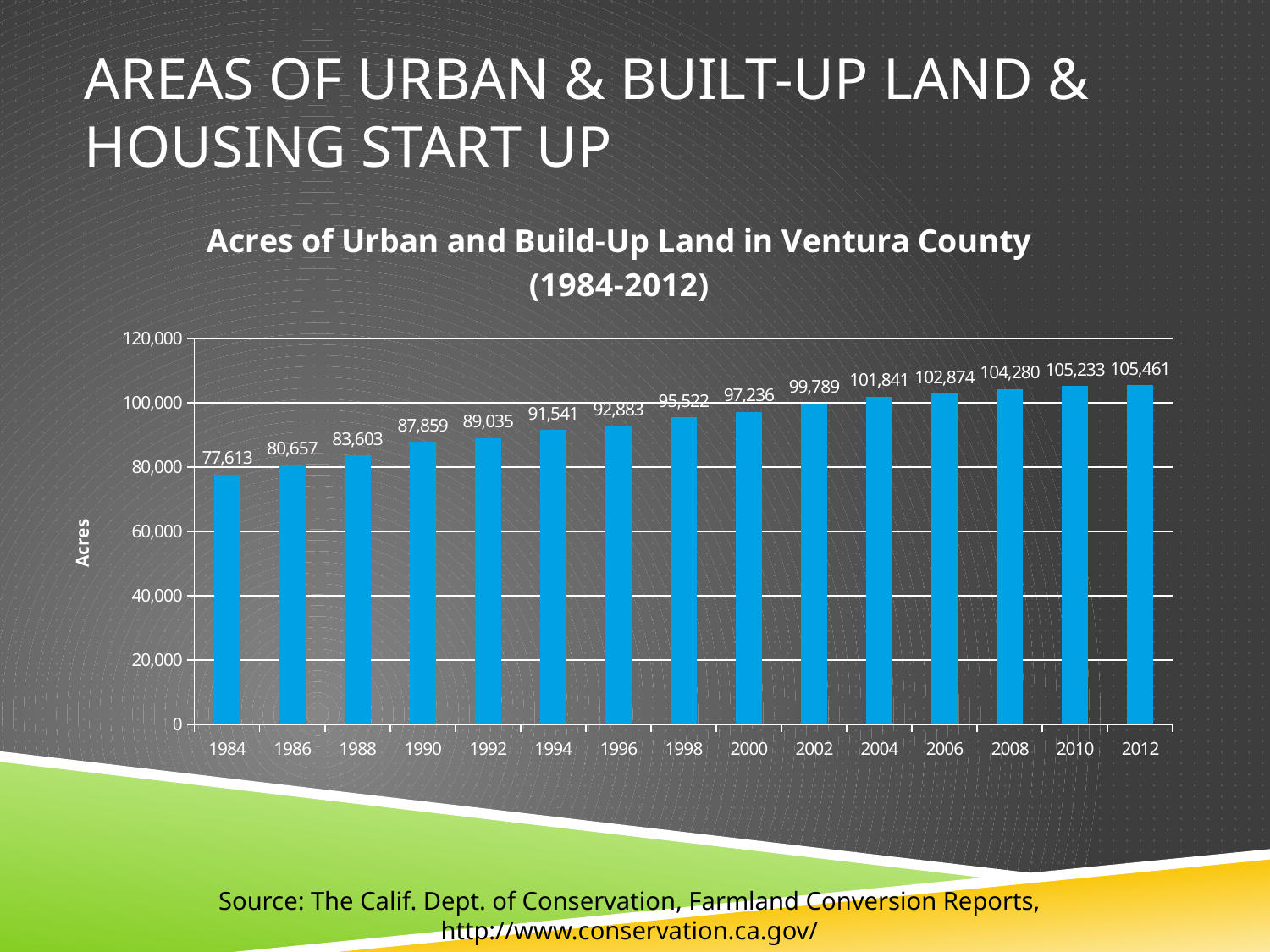
Which is larger, the value for 1992 or the value for 2004? 2004 What is the value for 1984 in the chart? 77,613 Which year has the lowest value in the chart? 1984 Which year has the highest value in the chart? 2012 Do the values rise or fall from 1984 to 2012? Rise What is the value for 2008 in the chart? 104,280 How many bars are shown in the chart? 15 What is the difference between the values for 2012 and 1984? 27,848 Is the value for 1990 greater or less than 80,000? greater What is the difference between the values for 2000 and 1998? 1,714 What is the value for 2000 in the chart? 97,236 What kind of chart is shown on the slide? Bar chart